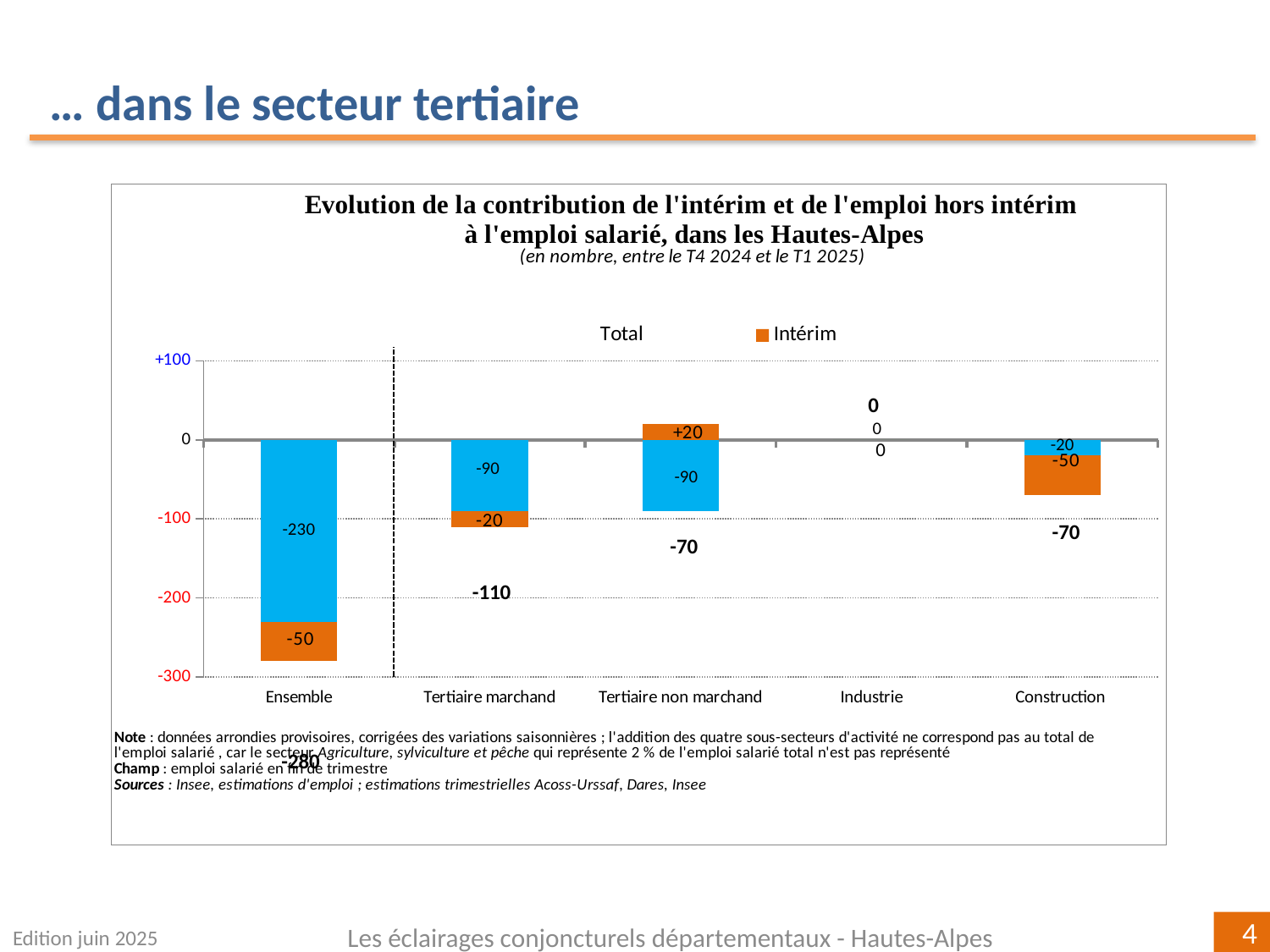
Which category has the highest total value? Industrie What kind of chart is this? Stacked bar chart Which category has the lowest total value? Ensemble What is the total shown for Tertiaire marchand? -110 What is the Intérim value for Ensemble? -50 What is the total shown for Ensemble? -280 Is the Intérim value for Tertiaire non marchand larger than the Intérim value for Construction? Yes How many categories are shown on the x axis? 5 What is the Intérim value for Tertiaire non marchand? +20 What is the Intérim value for Construction? -50 What is the difference between the blue values for Ensemble and Tertiaire marchand? 140 What is the blue (non-intérim) value for Tertiaire marchand? -90